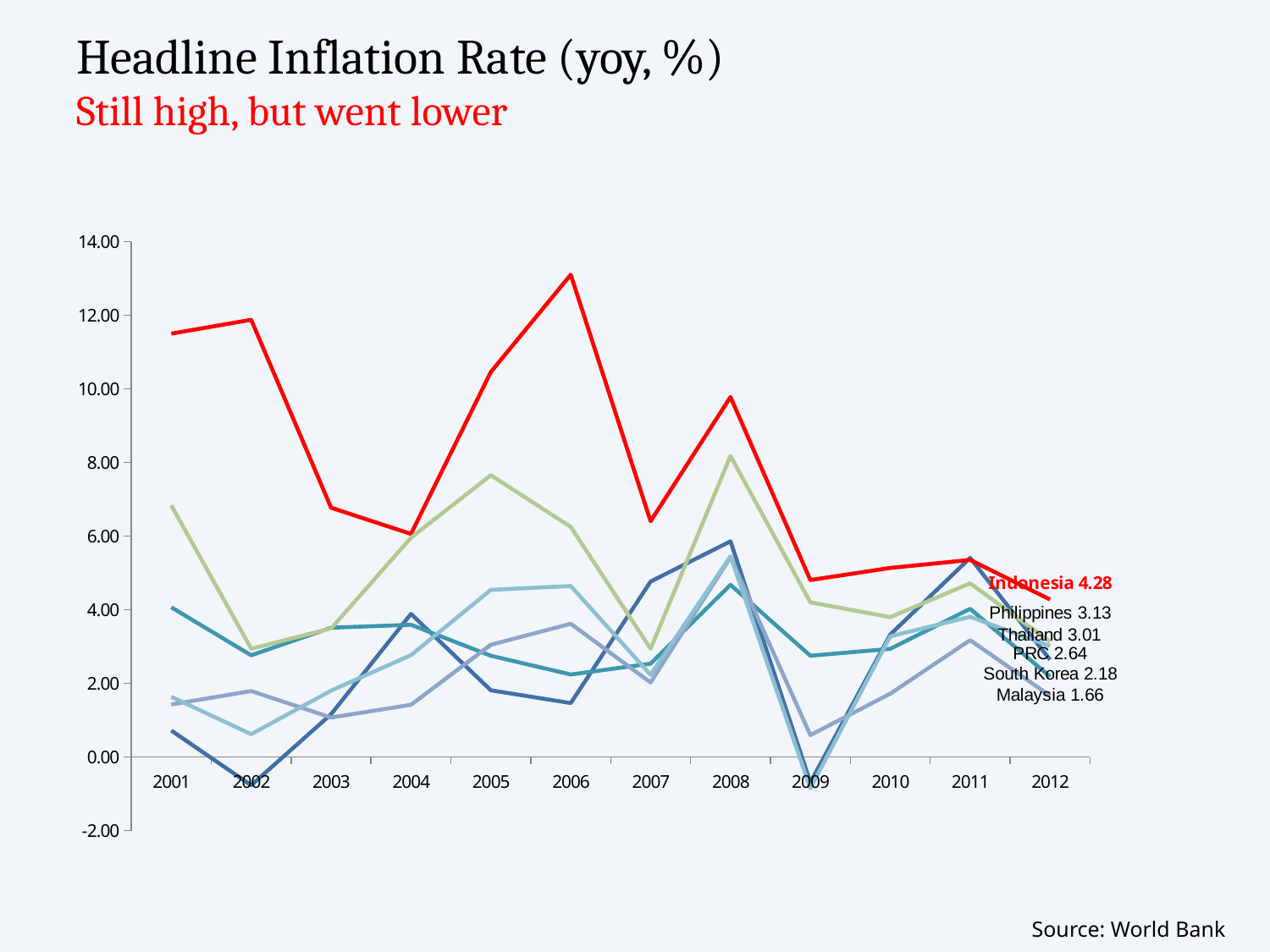
Which has the higher inflation rate in 2012, the PRC or South Korea? PRC Is Indonesia's inflation rate in 2006 greater or less than 12.00? greater How many years are shown along the x axis of the chart? 12 Which country has the highest headline inflation rate in 2012? Indonesia What kind of chart is shown on the slide? line chart How many countries are plotted as lines on the chart? 6 What is the title of the chart on the slide? Headline Inflation Rate (yoy, %) Which country has the lowest headline inflation rate in 2012? Malaysia What is Malaysia's headline inflation rate in 2012? 1.66 What is Indonesia's headline inflation rate in 2012? 4.28 What is the difference between Indonesia's and Malaysia's inflation rates in 2012? 2.62 What is the PRC's headline inflation rate in 2012? 2.64